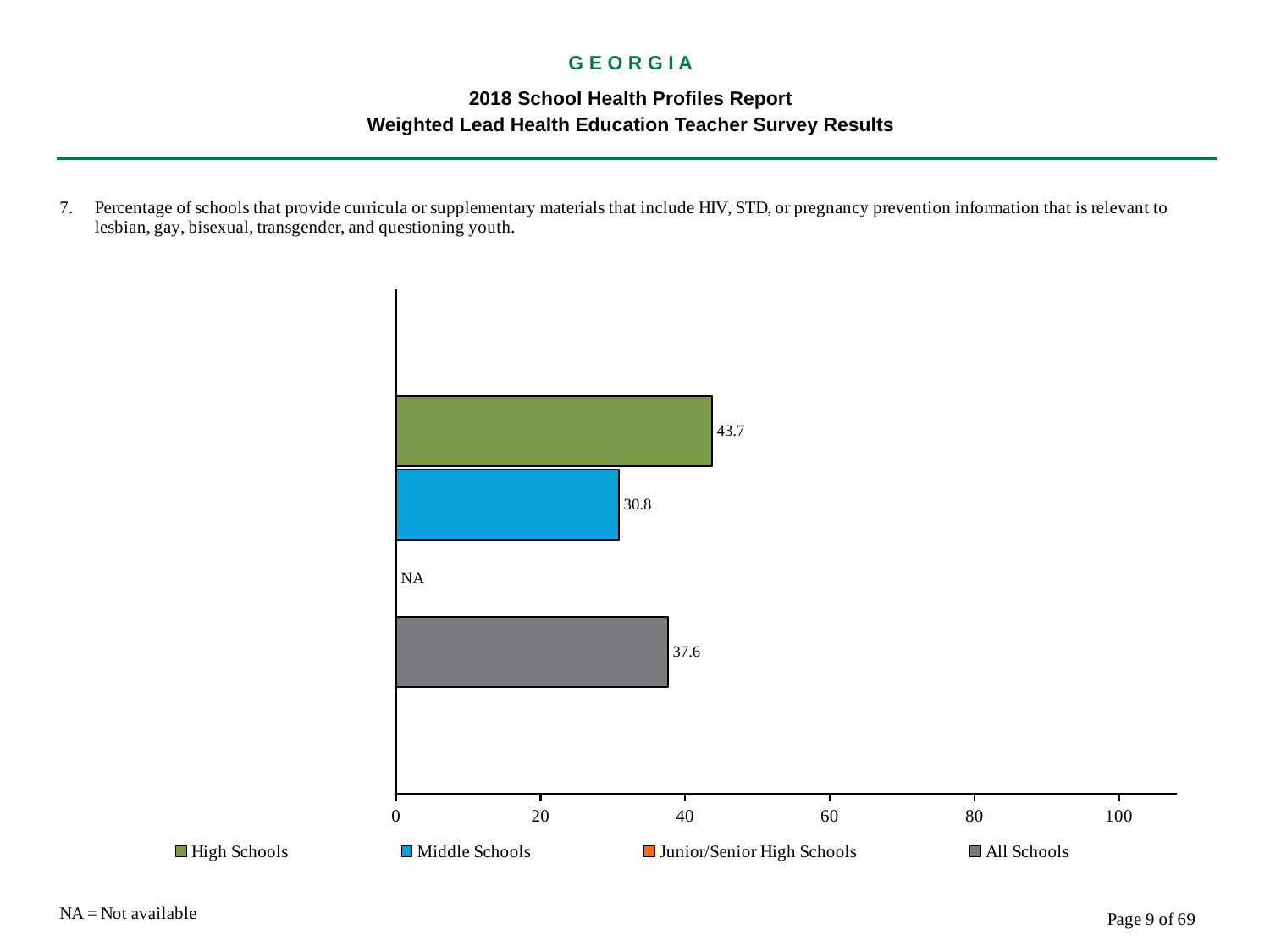
Is the value for High Schools greater or less than 40? greater Which is larger, the value for All Schools or the value for Middle Schools? All Schools Which school type has the highest value? High Schools What does NA stand for according to the note on the slide? Not available How many series does the legend list? 4 Which school type with a plotted value has the lowest value? Middle Schools What is the value for High Schools? 43.7 What kind of chart is shown? bar chart What is shown for Junior/Senior High Schools? NA What is the difference between the High Schools and Middle Schools values? 12.9 What is the value for All Schools? 37.6 What is the value for Middle Schools? 30.8